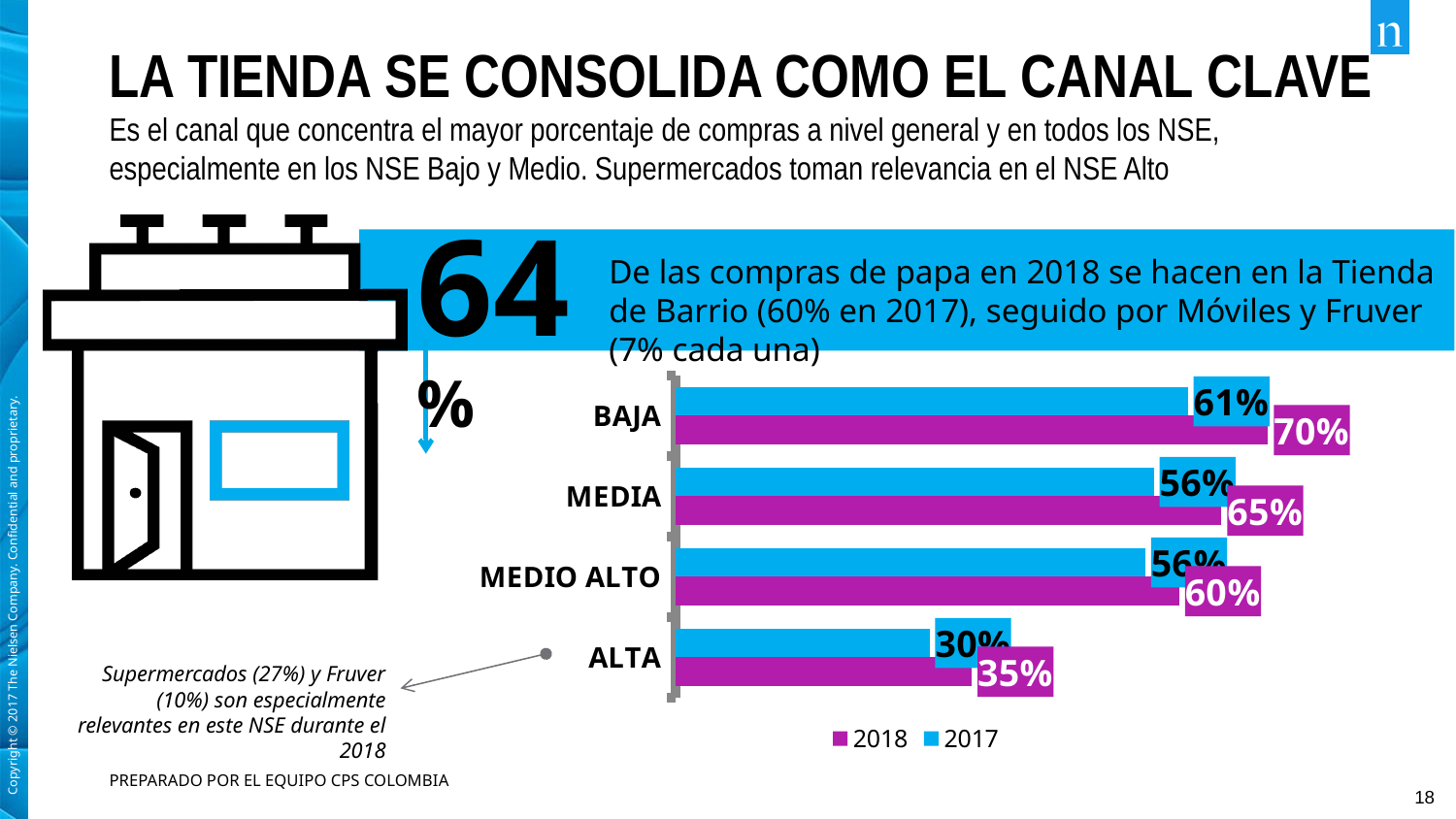
How many NSE categories are shown in the chart? 4 Which colour represents the 2017 series in the chart? blue Which category has the highest 2018 value? BAJA What is the difference between the 2018 and 2017 values for MEDIA? 9% Which is larger for MEDIO ALTO, the 2018 value or the 2017 value? 2018 What is the 2017 value for MEDIO ALTO? 56% What is the 2017 value for MEDIA? 56% What is the 2018 value for BAJA? 70% What is the 2018 value for ALTA? 35% How many series does the chart legend list? 2 Which category has the lowest 2017 value? ALTA What type of chart is shown on the slide? bar chart